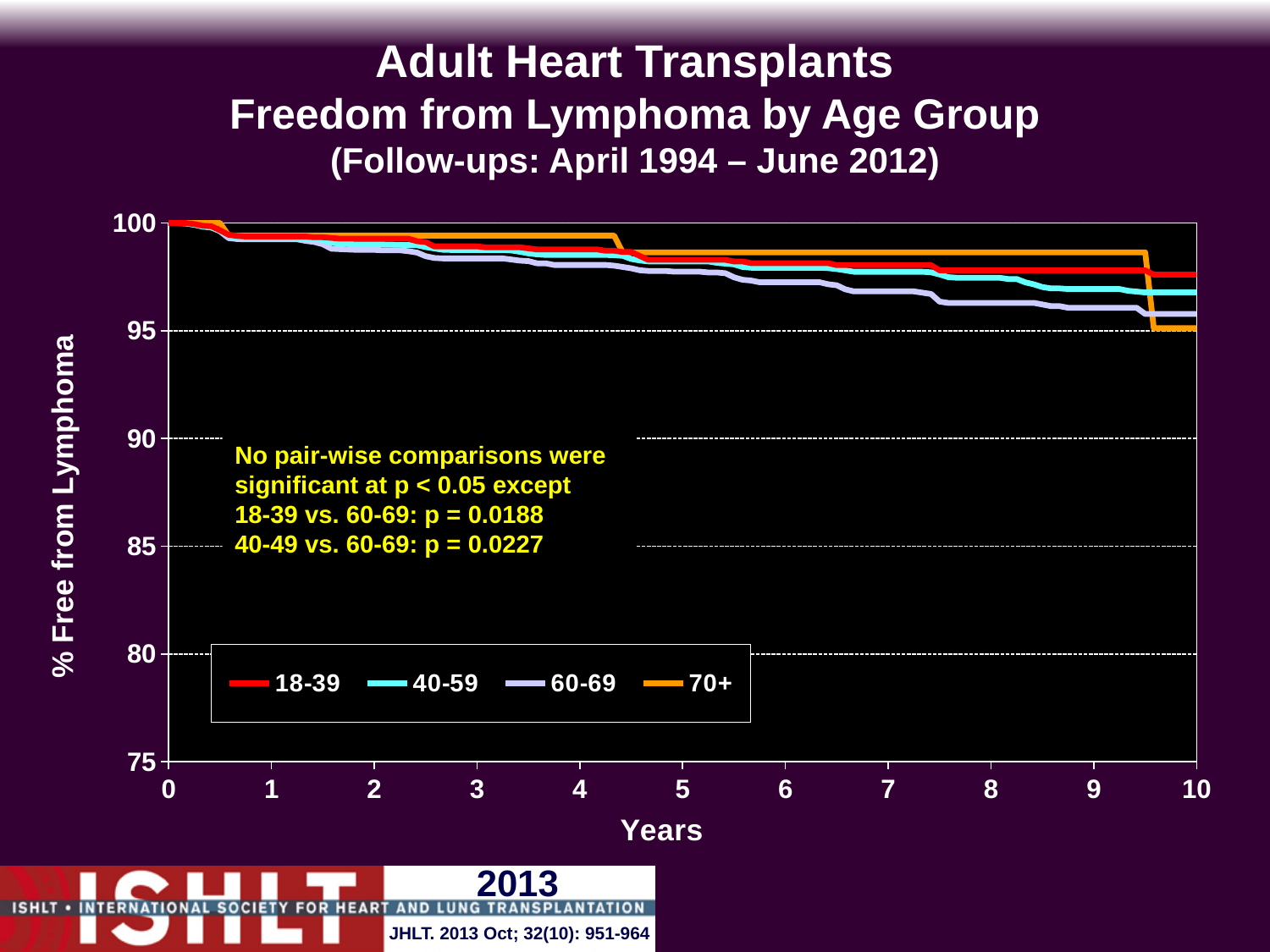
Is the value for the 18-39 group at year 10 greater or less than 95? greater At year 3, which group has the larger value: 70+ or 60-69? 70+ Which age group has the highest % Free from Lymphoma at year 10? 18-39 What is the label of the y axis? % Free from Lymphoma How many age groups does the legend list? 4 Do the % Free from Lymphoma values rise or fall as the years increase? fall Is the value for the 60-69 group at year 10 greater or less than 95? greater Is the value for the 70+ group at year 3 greater or less than 95? greater What kind of chart is shown on the slide? line chart According to the note on the chart, what is the p-value for 18-39 vs. 60-69? p = 0.0188 Which age group has the lowest % Free from Lymphoma at year 10? 70+ At year 10, which group has the larger value: 18-39 or 70+? 18-39